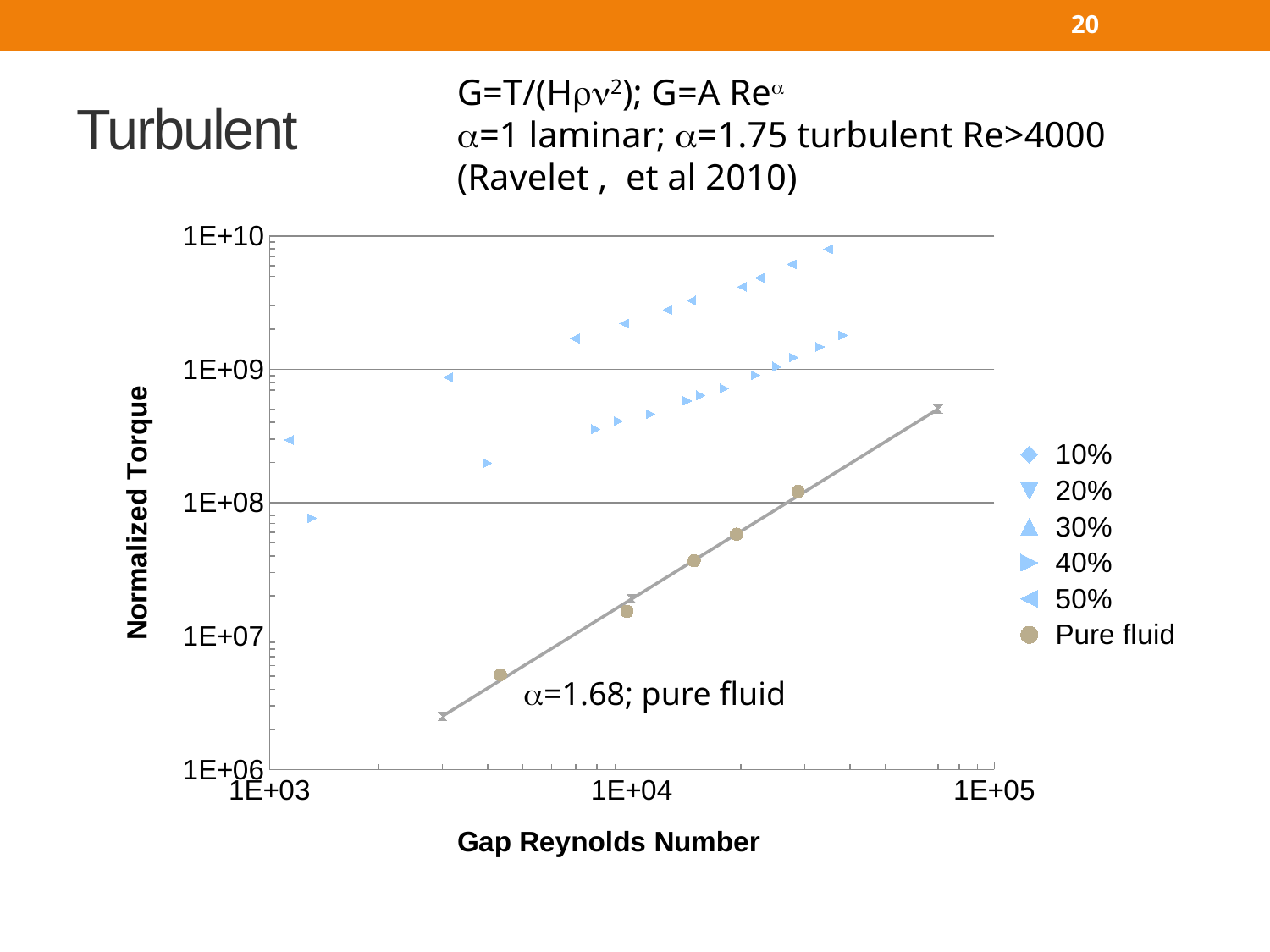
What is the title of the vertical axis? Normalized Torque Which series has the lowest normalized torque values on the chart? Pure fluid Is the Pure fluid normalized torque at a Gap Reynolds Number of 1E+04 greater or less than 1E+07? greater How many Pure fluid data points are plotted on the chart? 5 What value of α is annotated on the chart for the pure fluid? 1.68 Is the highest Pure fluid data point greater or less than 1E+09? less How many series does the legend list? 6 What is the title of the horizontal axis? Gap Reynolds Number At a Gap Reynolds Number of about 1E+04, which series has the larger normalized torque, 50% or Pure fluid? 50% What kind of chart is shown on the slide? Scatter chart Which series reaches the highest normalized torque on the chart? 50% Does the normalized torque for the Pure fluid series rise or fall as the Gap Reynolds Number increases? Rise